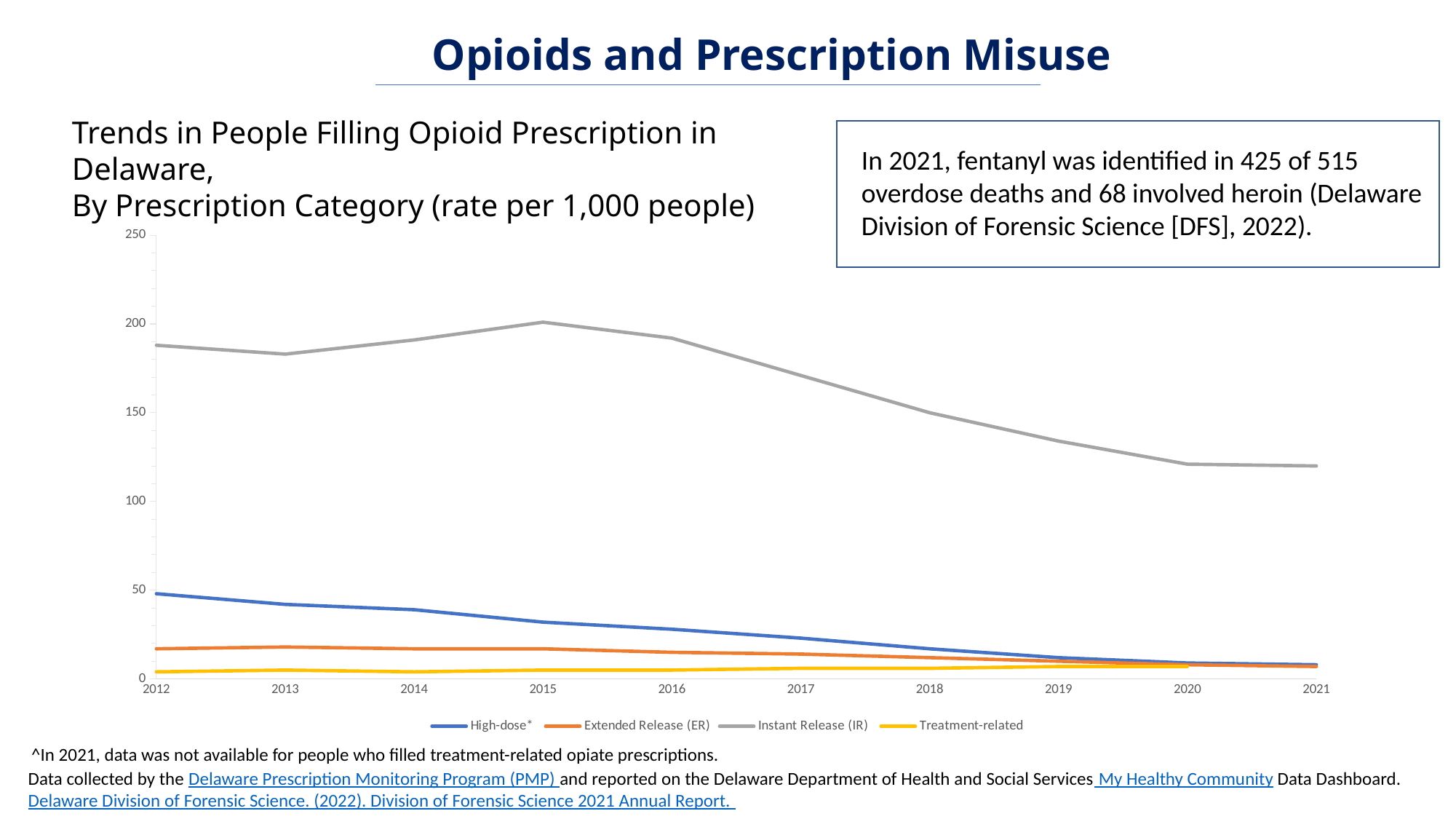
What colour is the Instant Release (IR) line in the legend? grey Does the High-dose* line rise or fall from 2012 to 2021? fall How many years are plotted along the x axis? 10 What kind of chart is shown on the slide? line chart How many series does the legend list? 4 Which prescription category has the lowest rate in 2012? Treatment-related Is the value for Instant Release (IR) in 2021 greater or less than 150? less Is the value for Instant Release (IR) in 2012 greater or less than 150? greater Which is larger in 2016, the Instant Release (IR) rate or the High-dose* rate? Instant Release (IR) In which year does the Instant Release (IR) line reach its peak? 2015 Is the value for High-dose* in 2012 greater or less than 100? less Which prescription category has the highest rate across all years shown? Instant Release (IR)